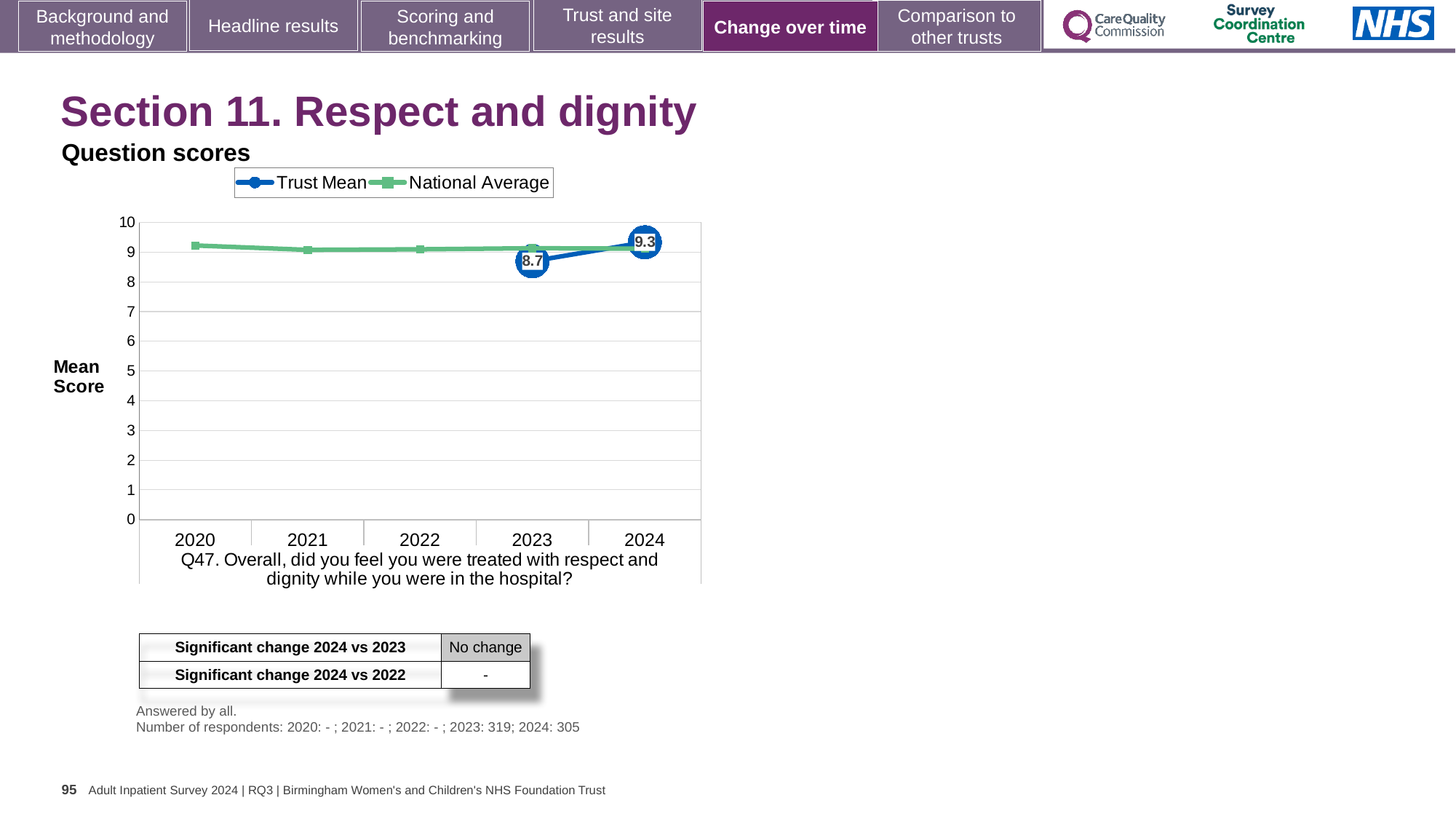
What is the difference between the Trust Mean in 2024 and in 2023? 0.6 What kind of chart is shown on the slide? line chart Which year has the higher Trust Mean, 2023 or 2024? 2024 What is the Trust Mean value for 2024? 9.3 How many series does the legend list? 2 What is the Trust Mean value for 2023? 8.7 How many years are shown on the x axis? 5 What is the title of the y axis? Mean Score In which year is the Trust Mean lowest? 2023 In which year is the Trust Mean highest? 2024 Does the Trust Mean rise or fall from 2023 to 2024? rise Is the National Average value for 2020 greater or less than 8? greater